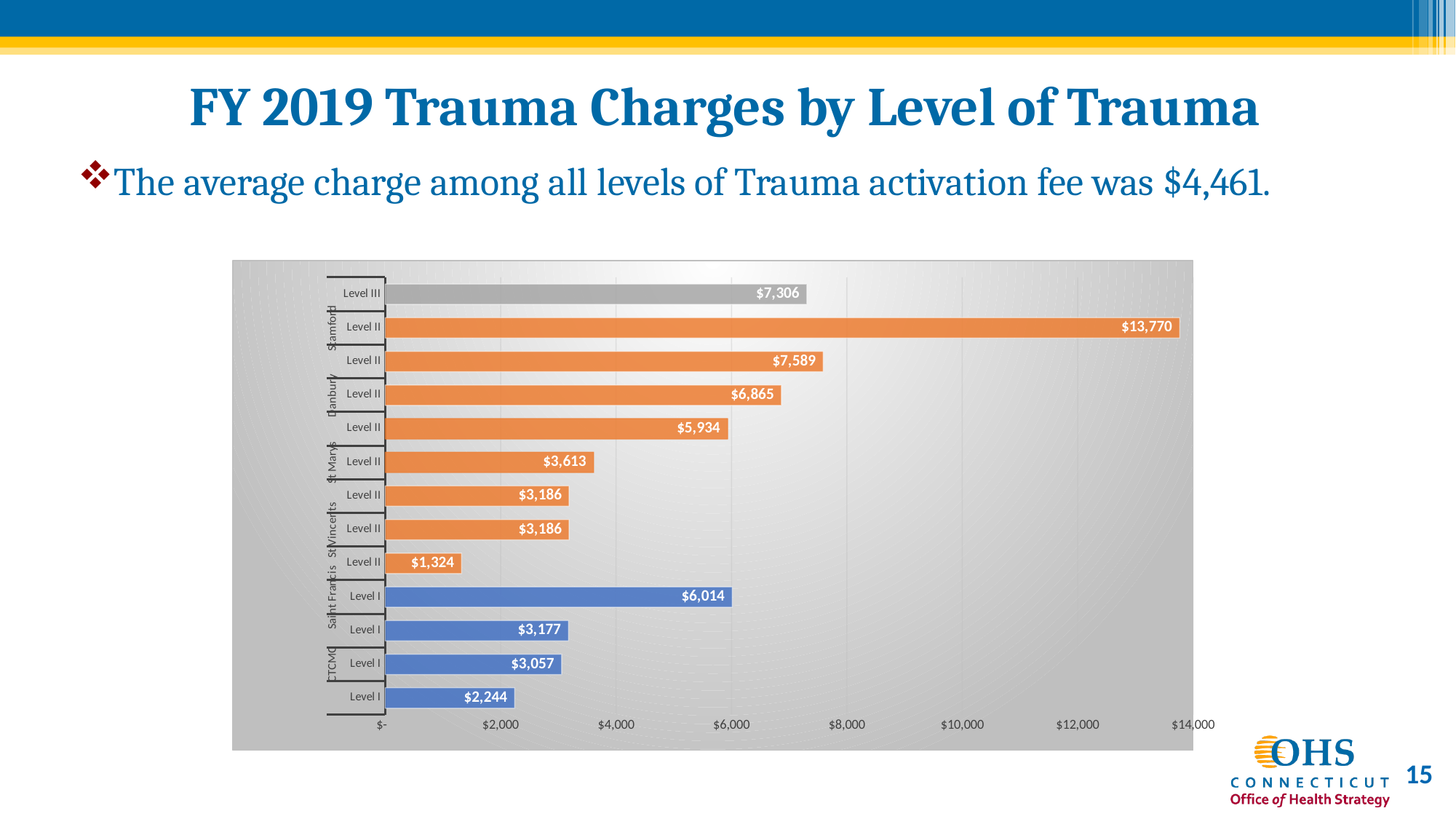
Which is larger: the Level III charge of $7,306 or the highest Level I charge of $6,014? Level III ($7,306) What is the charge shown for the Level III bar? $7,306 What kind of chart is shown on the slide? bar chart What colour are the Level I bars in the chart? blue What is the highest charge shown in the chart? $13,770 How many bars are labelled Level II in the chart? 8 What is the lowest charge shown in the chart? $1,324 How many bars are labelled Level I in the chart? 4 Is the highest bar in the chart greater or less than $12,000? greater What is the difference between the highest charge ($13,770) and the lowest charge ($1,324) in the chart? $12,446 What is the charge shown for the bottom bar of the chart? $2,244 How many bars are plotted in the chart? 13